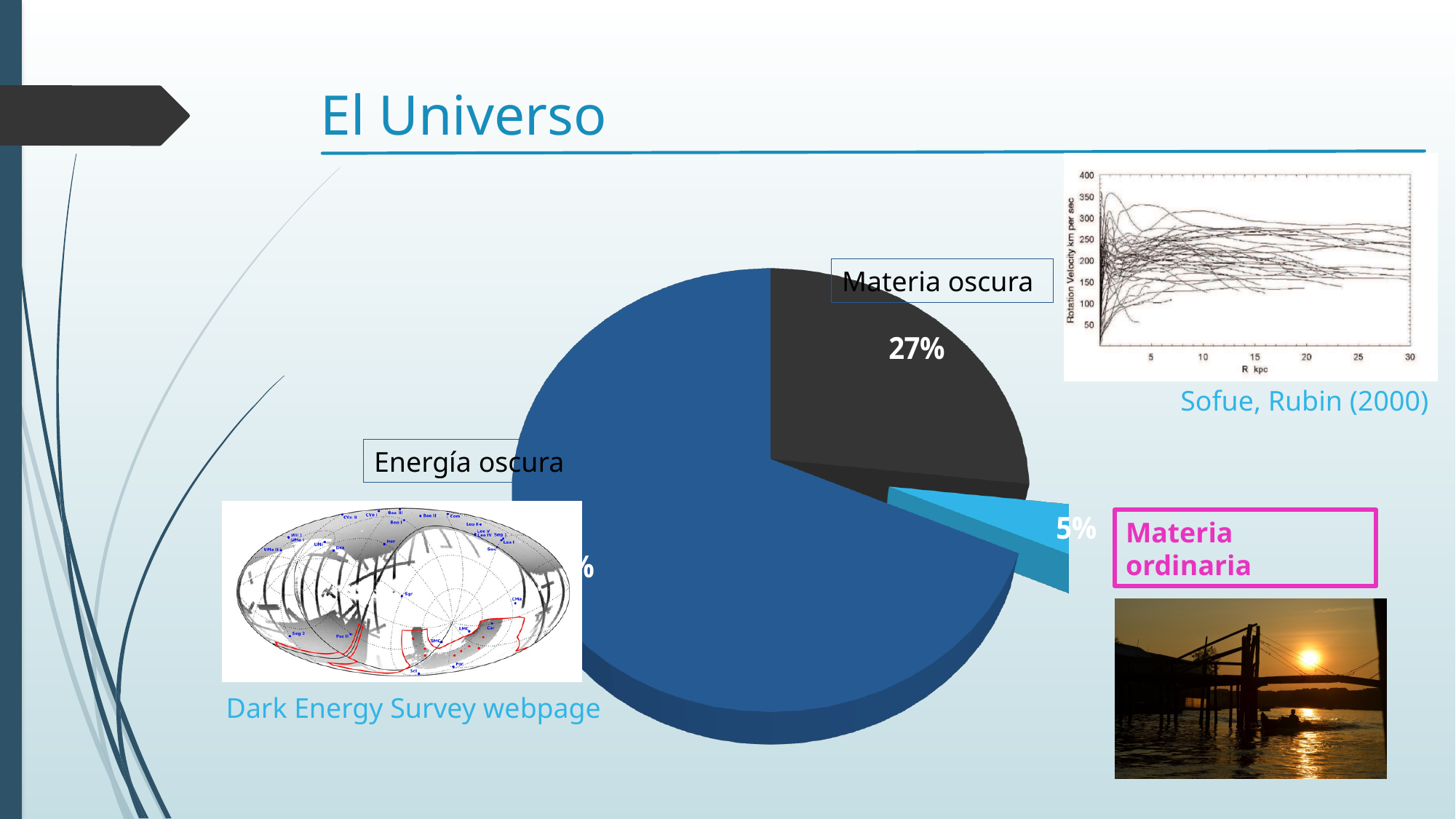
What kind of chart is the large chart in the centre of the slide? pie chart What share of the pie does the Materia oscura slice represent? 27% What colour is the Materia ordinaria slice in the pie chart? light blue Which slice of the pie chart is the largest? Energía oscura In the pie chart, what percentage is shown for Materia ordinaria? 5% What is the x-axis label of the rotation velocity plot in the top right of the slide? R kpc In the pie chart, what percentage is shown for Materia oscura? 27% How many slices does the pie chart have? 3 Which slice of the pie chart is the smallest? Materia ordinaria What is the difference in percentage points between the Materia oscura slice and the Materia ordinaria slice? 22 In the pie chart, which is larger: Materia oscura or Materia ordinaria? Materia oscura In the pie chart, which is larger: Energía oscura or Materia oscura? Energía oscura